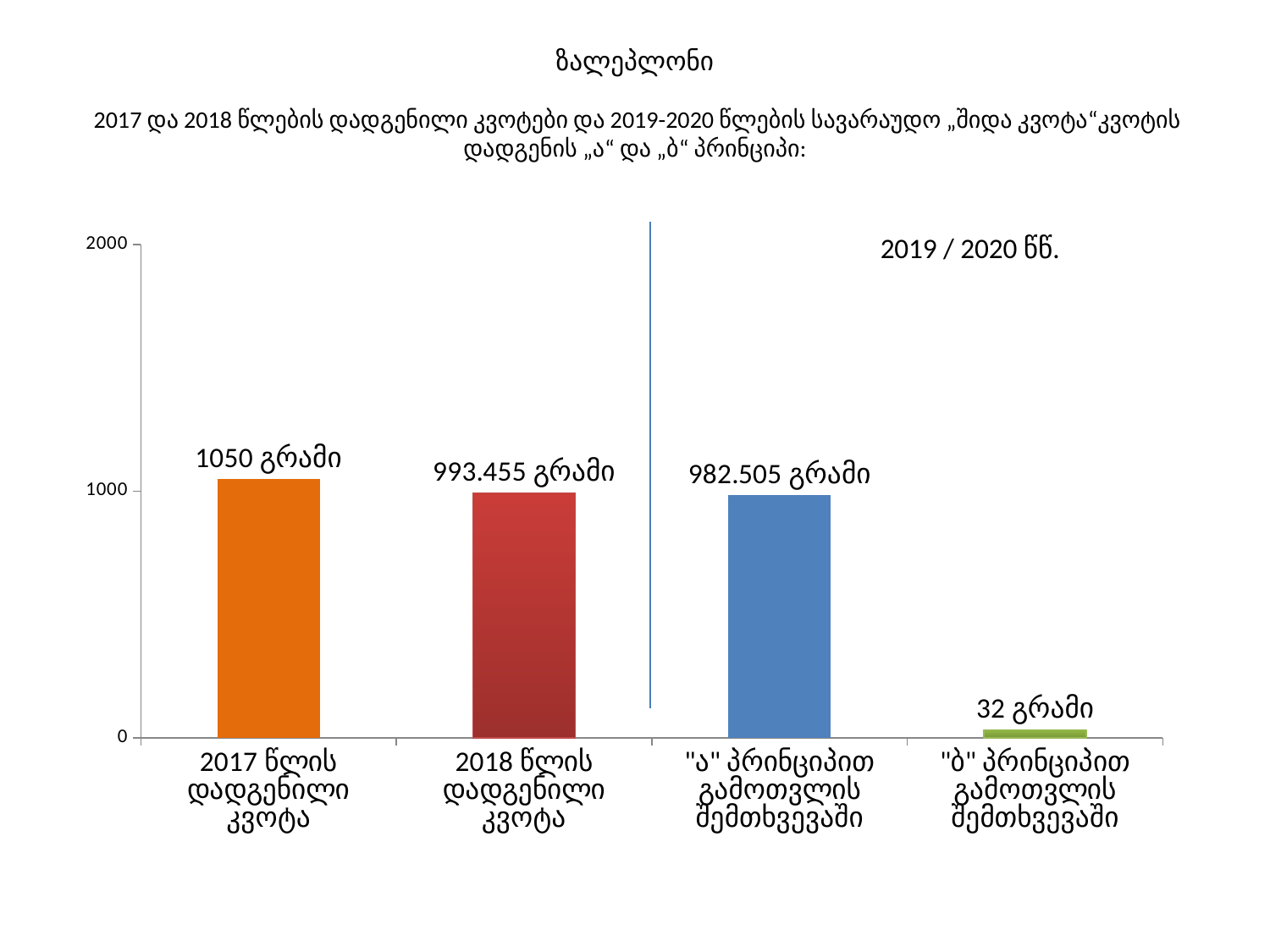
What is the value for ""ბ" პრინციპით გამოთვლის შემთხვევაში"? 32 გრამი How many bars are shown in the chart? 4 Is the value for "2017 წლის დადგენილი კვოტა" greater or less than 1000? greater What is the value for "2017 წლის დადგენილი კვოტა"? 1050 გრამი What is the value for "2018 წლის დადგენილი კვოტა"? 993.455 გრამი Which is larger: the 2018 quota or the "ა" principle value? 2018 წლის დადგენილი კვოტა Which category has the highest value? 2017 წლის დადგენილი კვოტა What is the difference between the 2017 quota (1050 გრამი) and the 2018 quota (993.455 გრამი)? 56.545 გრამი Which category has the lowest value? "ბ" პრინციპით გამოთვლის შემთხვევაში What type of chart is shown on the slide? bar chart What is the difference between the "ა" principle value and the "ბ" principle value? 950.505 გრამი What is the value for ""ა" პრინციპით გამოთვლის შემთხვევაში"? 982.505 გრამი